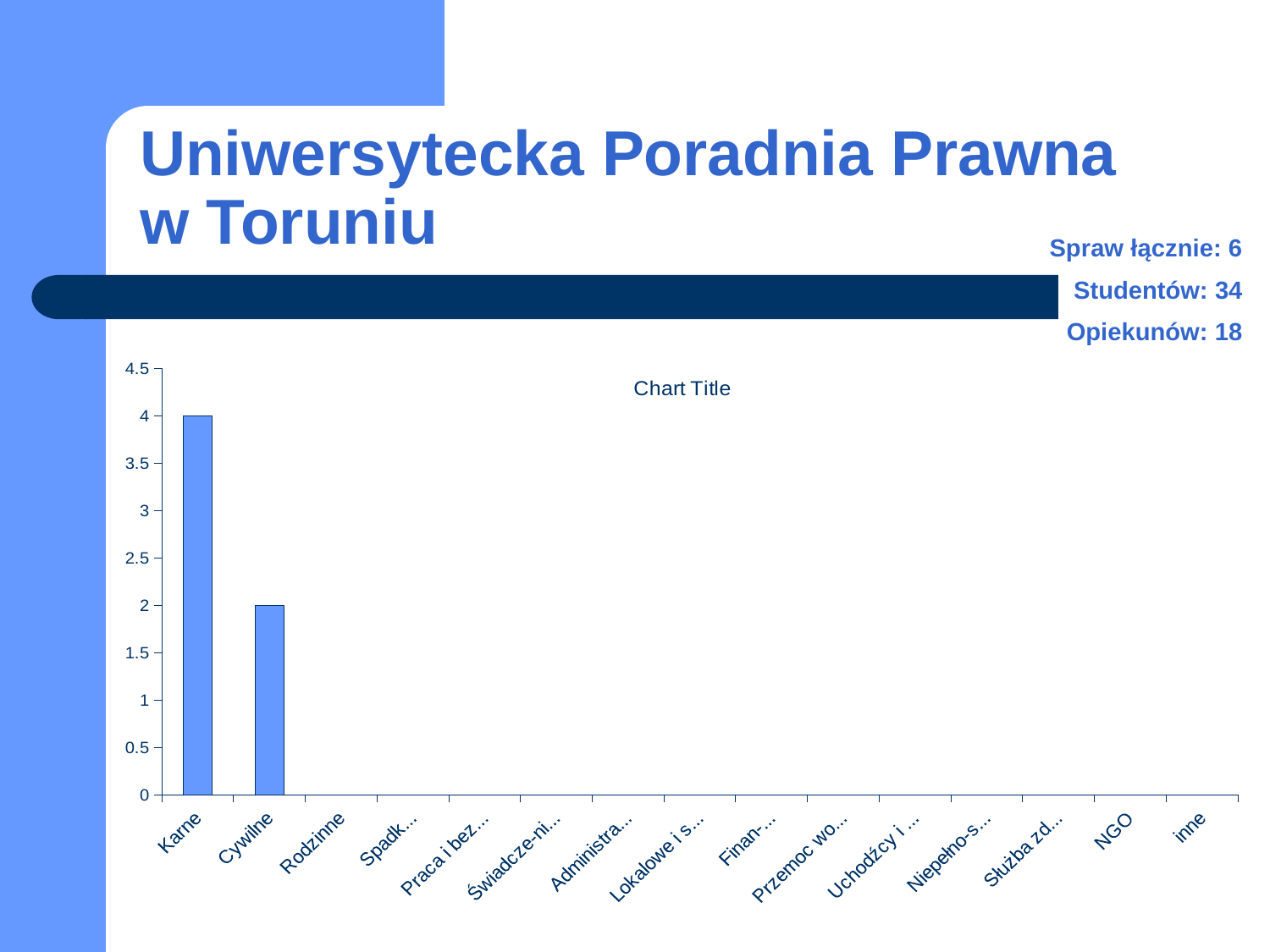
What is the value for Karne? 4 What is the title of the chart? Chart Title Which category has the highest bar? Karne How many categories have a visible bar above zero? 2 What is the highest value shown on the vertical axis? 4.5 What kind of chart is shown on the slide? bar chart Is the value for Cywilne greater or less than 3? less How many categories are shown on the x axis? 15 What is the difference between the values for Karne and Cywilne? 2 What is the value for Cywilne? 2 Which is larger, the value for Karne or the value for Cywilne? Karne Is the value for Karne greater or less than 3? greater